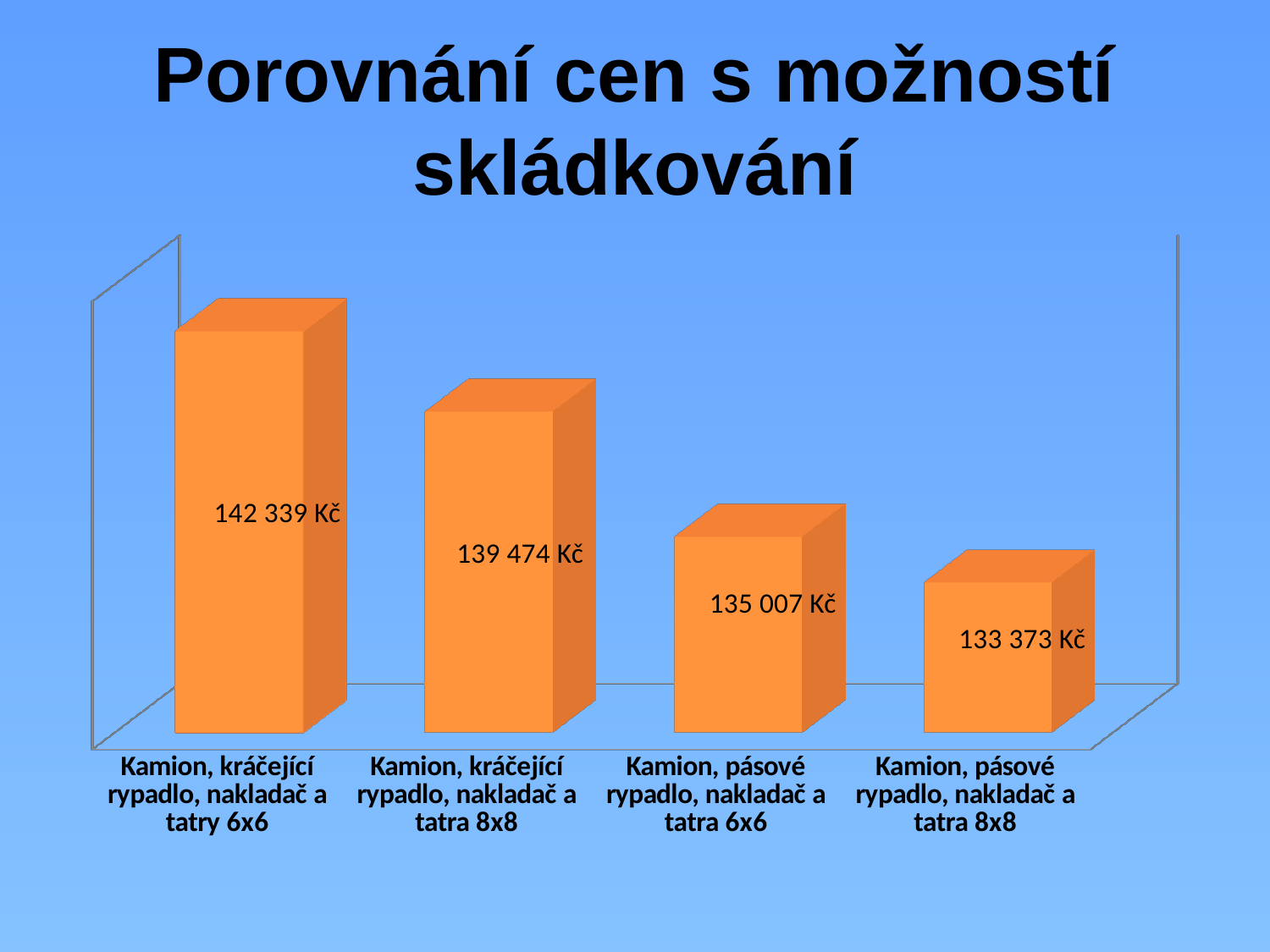
What is the value for "Kamion, kráčející rypadlo, nakladač a tatry 6x6"? 142 339 Kč What is the difference between the values for "Kamion, kráčející rypadlo, nakladač a tatry 6x6" and "Kamion, kráčející rypadlo, nakladač a tatra 8x8"? 2 865 Kč Do the values rise or fall from left to right across the categories? Fall Which category has the highest value? Kamion, kráčející rypadlo, nakladač a tatry 6x6 Which is larger: the value for "Kamion, pásové rypadlo, nakladač a tatra 6x6" or for "Kamion, pásové rypadlo, nakladač a tatra 8x8"? Kamion, pásové rypadlo, nakladač a tatra 6x6 What kind of chart is shown on the slide? Bar chart How many categories are shown in the chart? 4 What is the difference between the highest and the lowest value in the chart? 8 966 Kč What is the value for "Kamion, pásové rypadlo, nakladač a tatra 6x6"? 135 007 Kč What is the value for "Kamion, pásové rypadlo, nakladač a tatra 8x8"? 133 373 Kč Which category has the lowest value? Kamion, pásové rypadlo, nakladač a tatra 8x8 What is the value for "Kamion, kráčející rypadlo, nakladač a tatra 8x8"? 139 474 Kč